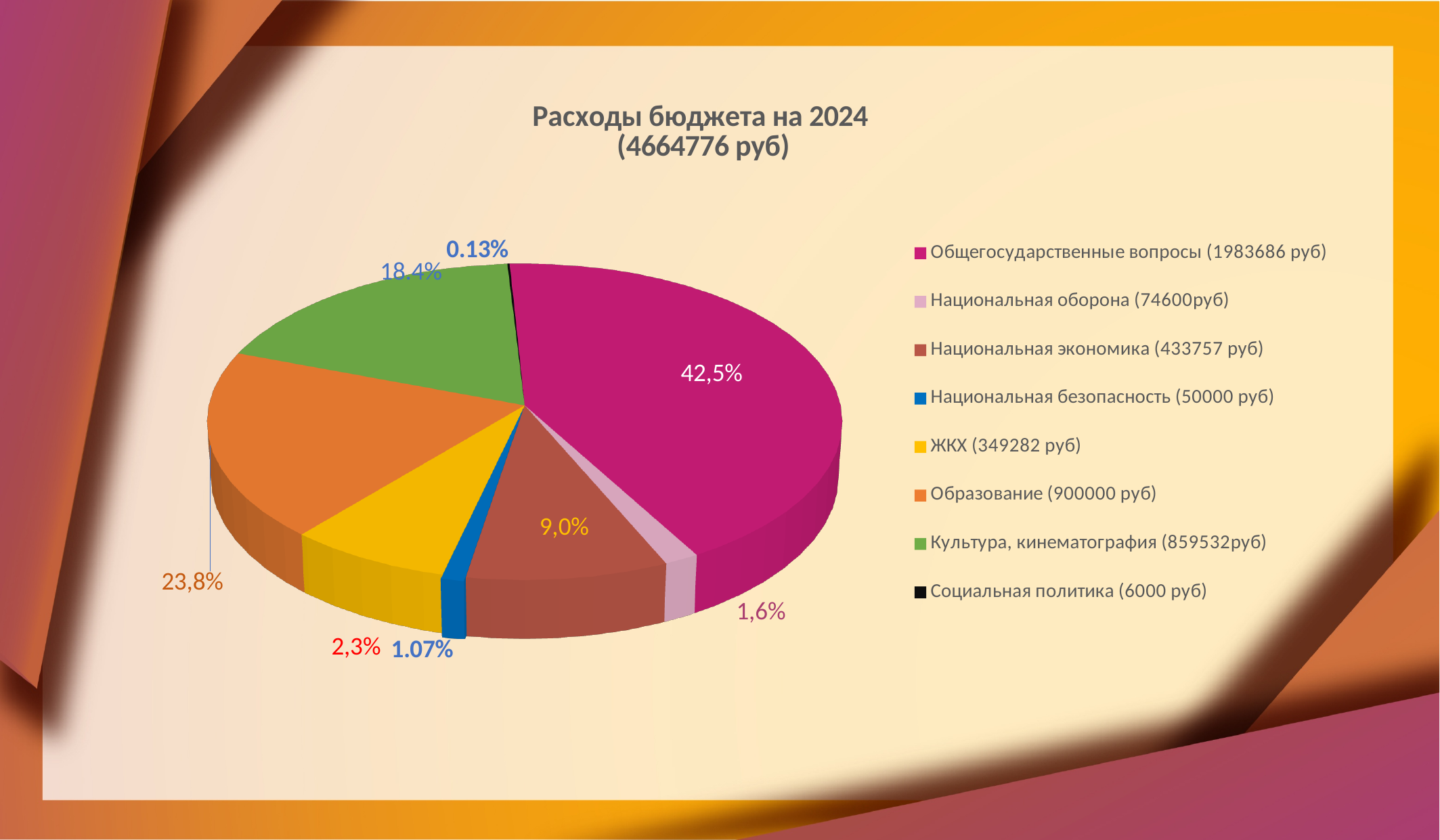
Which category has the smallest share of the pie? Социальная политика Which category has the largest share of the pie? Общегосударственные вопросы What percentage label is shown on the Общегосударственные вопросы slice? 42,5% What is the difference in rubles between Образование (900000 руб) and Культура, кинематография (859532 руб)? 40468 руб Which is larger according to the legend: Национальная экономика or Национальная оборона? Национальная экономика What total budget amount is given in the chart title? 4664776 руб What percentage label is shown for the Культура, кинематография slice? 18.4% What amount in rubles does the legend give for ЖКХ? 349282 руб What amount in rubles does the legend give for Образование? 900000 руб What kind of chart is shown on the slide? pie chart What percentage label is shown for the Социальная политика slice? 0.13% How many categories does the pie chart's legend list? 8